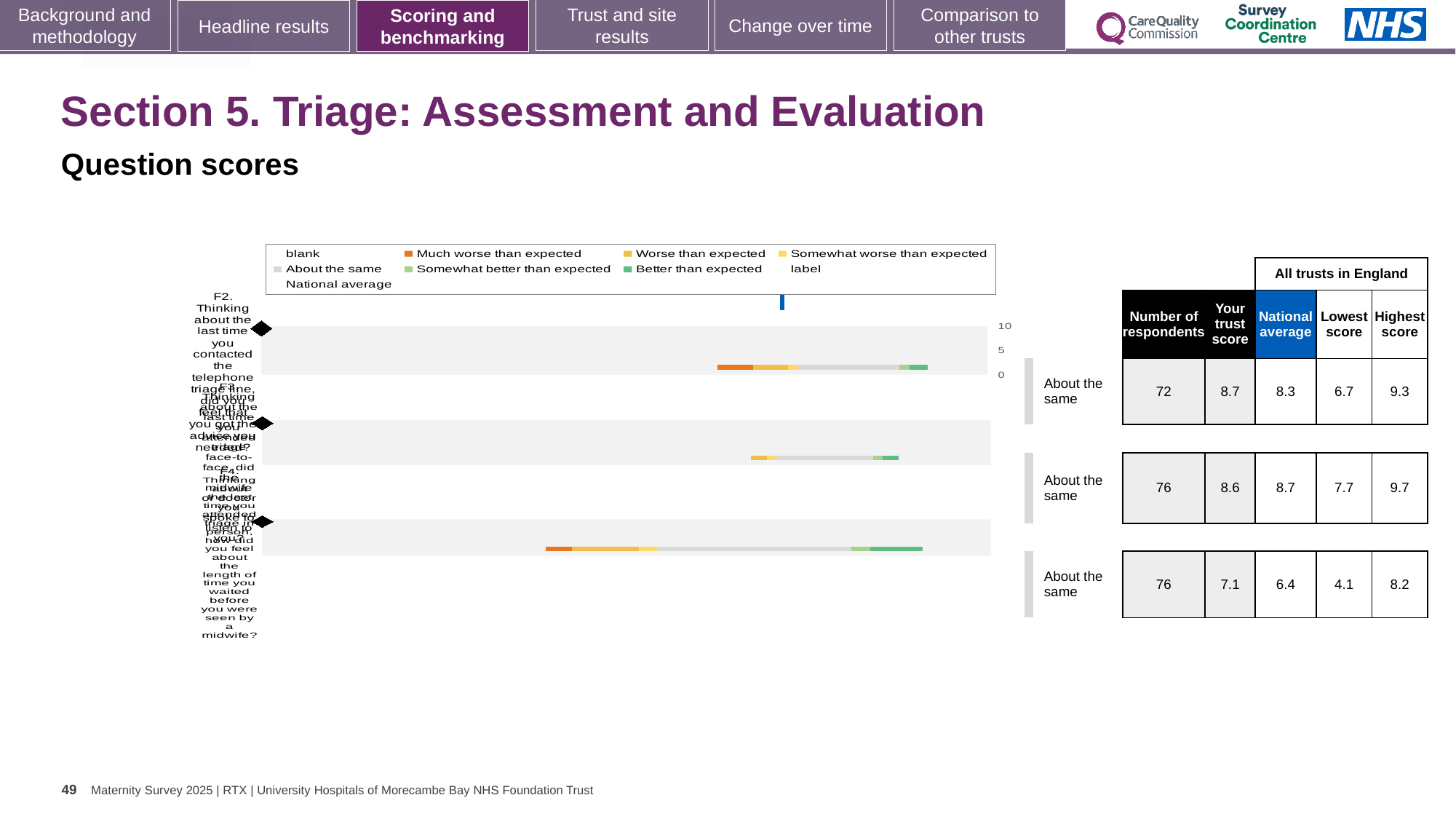
What is the difference between the trust score and the national average for the top row? 0.4 What benchmark category is shown for each of the three rows? About the same How many question rows (bars) does the chart show? 3 In the table next to the chart, what is the national average for the middle row? 8.7 In the table next to the chart, what is the highest score for the middle row? 9.7 For the bottom row, which is larger: the trust score or the national average? the trust score (7.1) In the table next to the chart, what is the trust score for the top row? 8.7 Which row in the table has the lowest trust score? the bottom row (7.1) In the table next to the chart, what is the lowest score for the bottom row? 4.1 What is the highest value shown on the chart's score axis? 10 What kind of chart is shown on the slide? bar chart In the table next to the chart, what is the number of respondents for the top row? 72